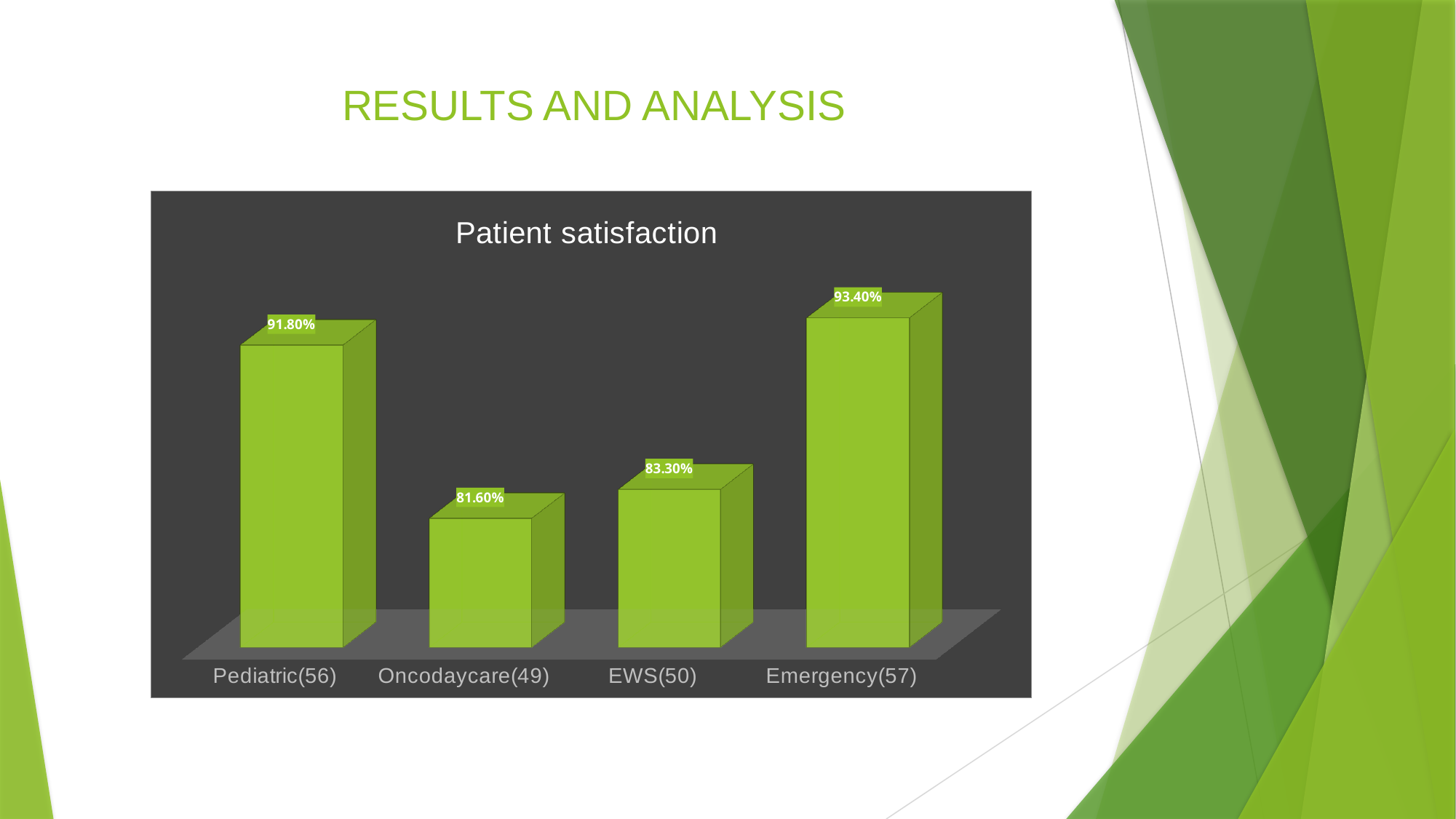
Which category has the lowest patient satisfaction? Oncodaycare(49) What is the patient satisfaction value for Pediatric(56)? 91.80% What is the patient satisfaction value for Oncodaycare(49)? 81.60% What is the patient satisfaction value for EWS(50)? 83.30% Which has a higher patient satisfaction, Pediatric(56) or EWS(50)? Pediatric(56) What kind of chart is shown on the slide? Bar chart What is the title of the chart? Patient satisfaction What is the patient satisfaction value for Emergency(57)? 93.40% What is the difference in patient satisfaction between Emergency(57) and Oncodaycare(49)? 11.80% What is the difference in patient satisfaction between Pediatric(56) and EWS(50)? 8.50% How many categories are shown in the chart? 4 Which category has the highest patient satisfaction? Emergency(57)